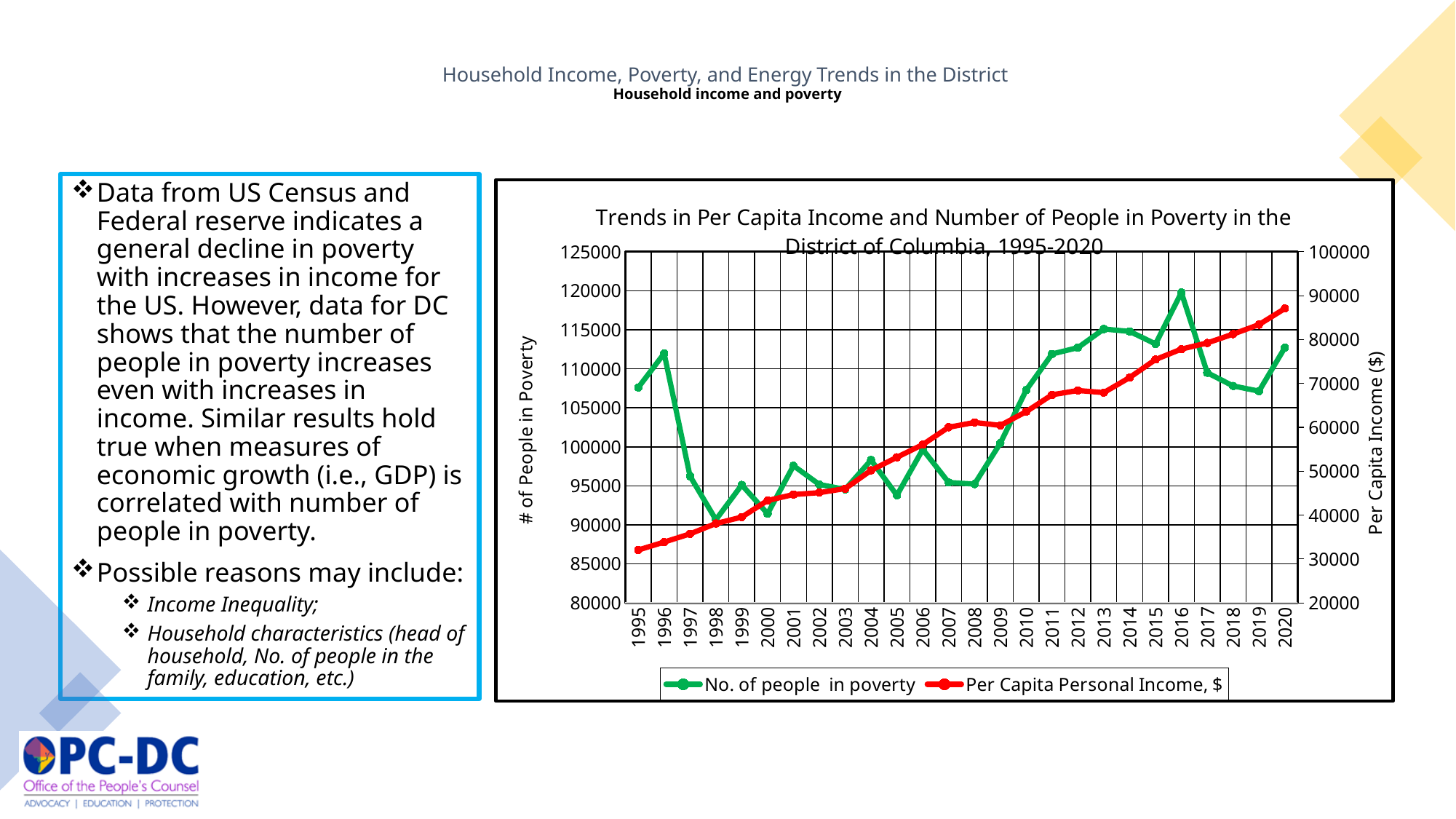
What is the label of the left vertical axis? # of People in Poverty Which series is drawn in red? Per Capita Personal Income, $ Is the Per Capita Personal Income in 1995 greater or less than 40000? less How many series does the legend list? 2 Which year has a larger number of people in poverty, 1996 or 1997? 1996 What kind of chart is shown on the slide? line chart Is the Per Capita Personal Income in 2020 greater or less than 80000? greater Is the number of people in poverty in 1998 greater or less than 95000? less Does the Per Capita Personal Income line generally rise or fall from 1995 to 2020? rise In which year is the number of people in poverty highest? 2016 How many years are plotted along the x axis? 26